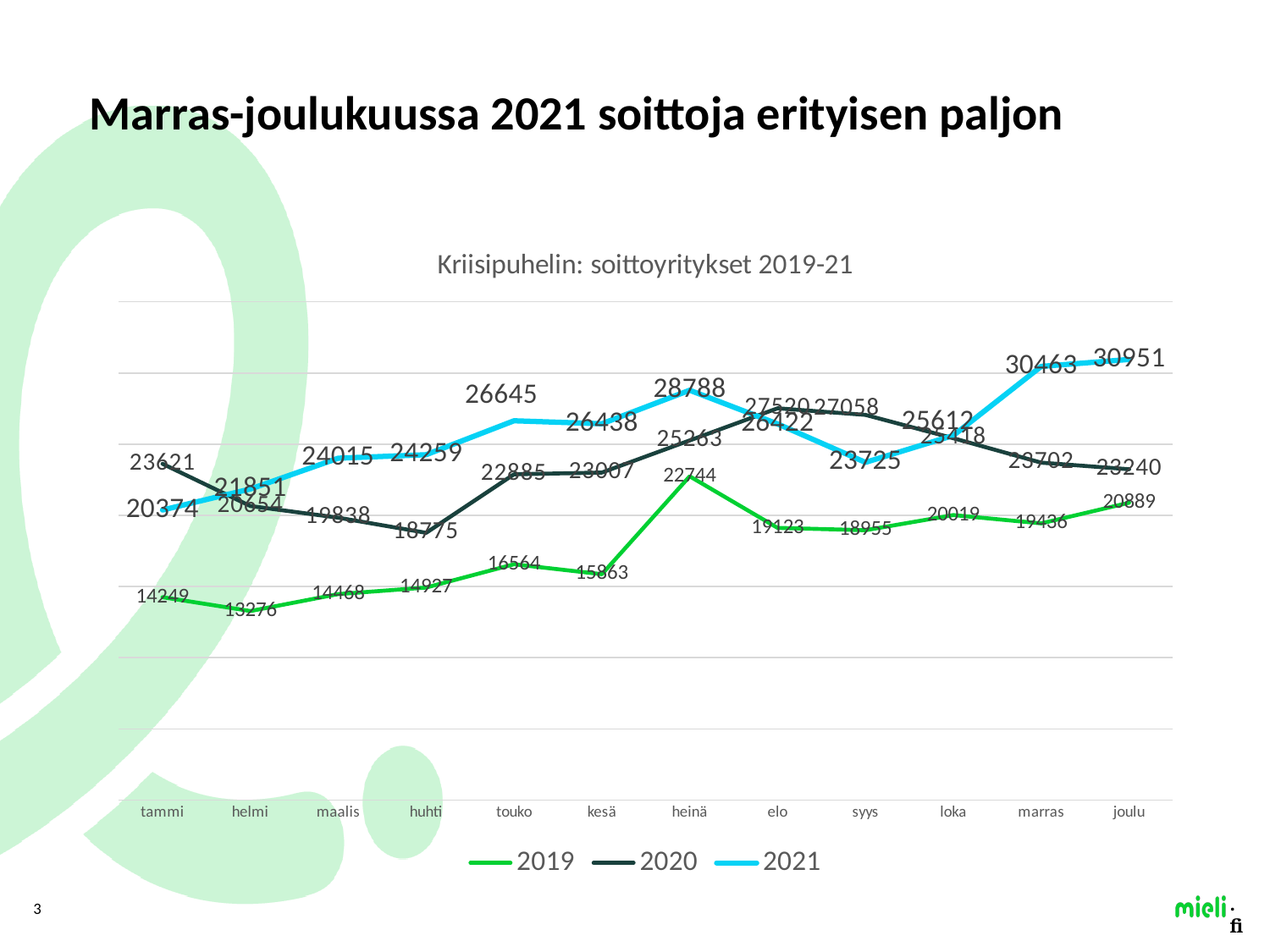
In which month does the 2021 series have its lowest value? tammi What is the value for 2020 in huhti? 18775 In which month does the 2021 series reach its highest value? joulu What is the difference between the 2021 values for joulu and marras? 488 How many series does the legend list? 3 What is the title of the chart? Kriisipuhelin: soittoyritykset 2019-21 What is the value for 2021 in joulu? 30951 In which month does the 2019 series have its lowest value? helmi What is the value for 2019 in helmi? 13276 Which series has the higher value in heinä, 2019 or 2021? 2021 How many months are shown along the x axis? 12 What kind of chart is shown on the slide? line chart